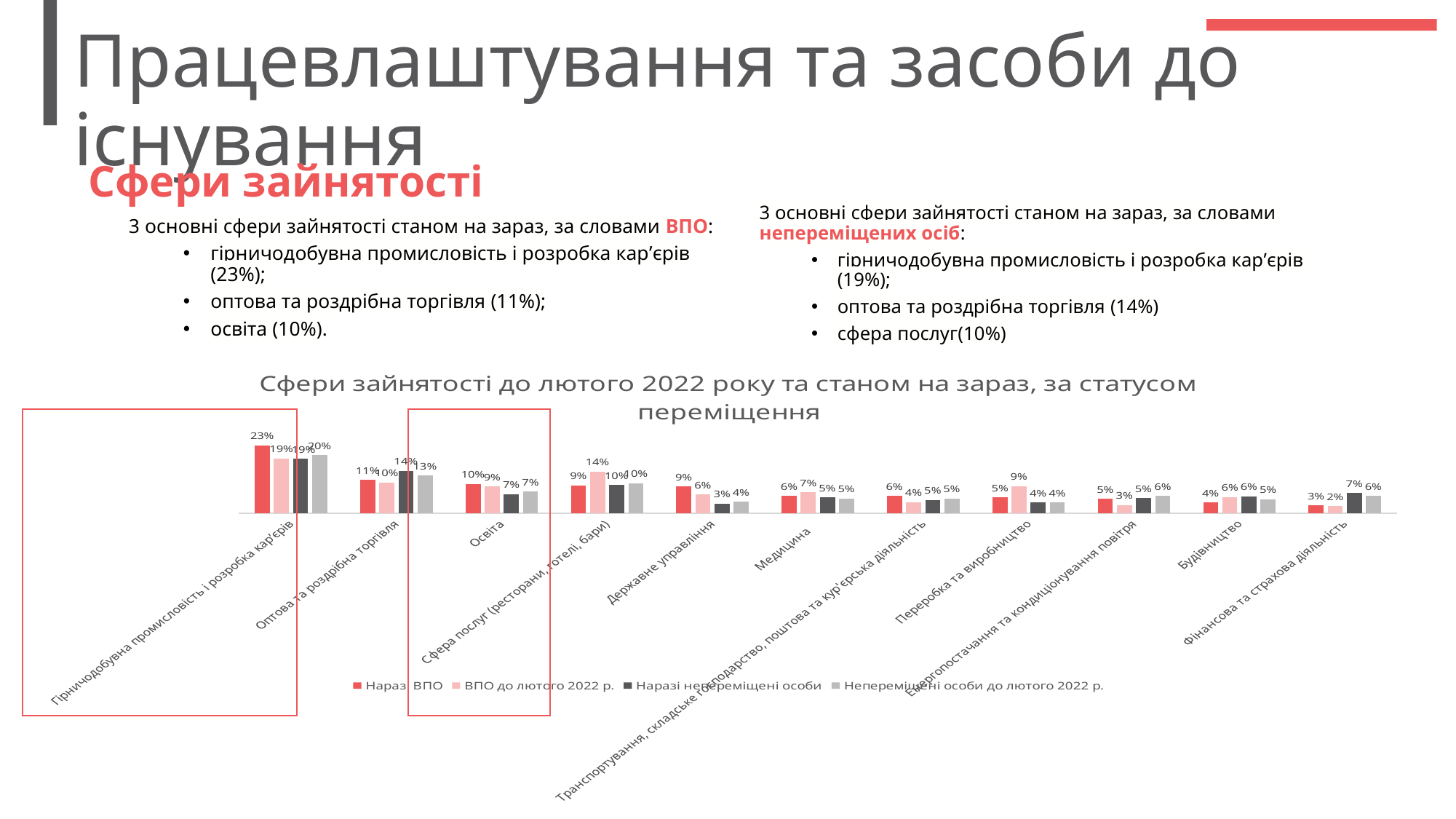
What is the value for 'ВПО до лютого 2022 р.' in the category 'Сфера послуг (ресторани, готелі, бари)'? 14% In the category 'Переробка та виробництво', which is larger: 'Наразі ВПО' or 'ВПО до лютого 2022 р.'? ВПО до лютого 2022 р. What is the value for 'Наразі непереміщені особи' in the category 'Фінансова та страхова діяльність'? 7% What is the title of the chart? Сфери зайнятості до лютого 2022 року та станом на зараз, за статусом переміщення How many categories are shown on the x axis of the chart? 11 Which category has the highest value for the 'Наразі ВПО' series? Гірничодобувна промисловість і розробка кар'єрів What type of chart is shown on the slide? bar chart How many series does the chart legend list? 4 What is the value for 'Наразі ВПО' in the category 'Гірничодобувна промисловість і розробка кар'єрів'? 23% What is the difference between 'Наразі ВПО' and 'Наразі непереміщені особи' in the category 'Державне управління'? 6% What is the value for 'Наразі непереміщені особи' in the category 'Оптова та роздрібна торгівля'? 14% Which category has the lowest value for the 'ВПО до лютого 2022 р.' series? Фінансова та страхова діяльність